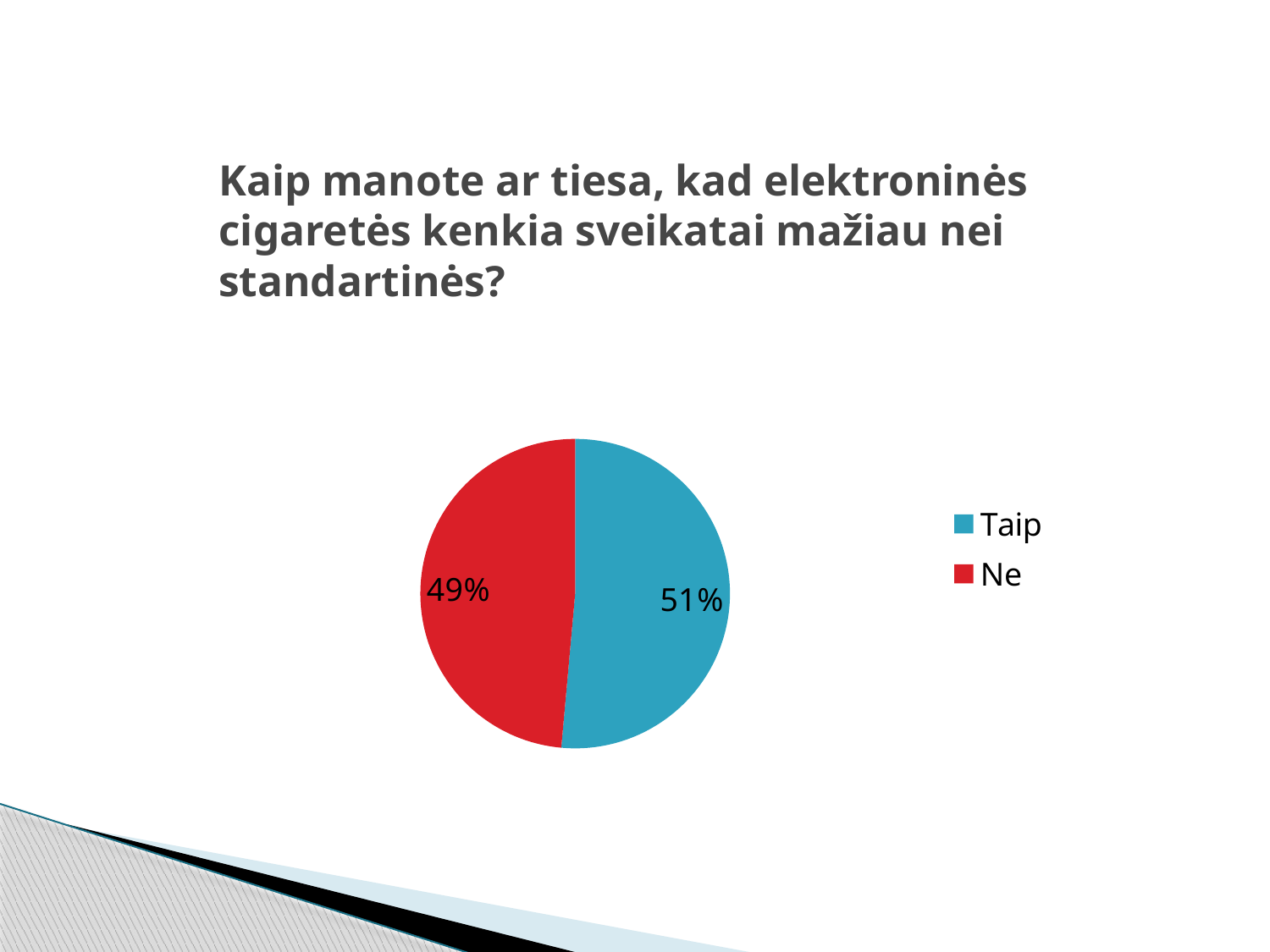
Which slice is the largest in the pie chart? Taip What kind of chart is shown on the slide? pie chart Which slice is the smallest in the pie chart? Ne What colour is the "Ne" slice in the pie chart? red What percentage of the pie is labelled "Taip"? 51% What colour is the "Taip" slice in the pie chart? blue What is the difference in percentage points between the "Taip" and "Ne" slices? 2 How many entries does the legend list? 2 What percentage of the pie is labelled "Ne"? 49% How many slices does the pie chart have? 2